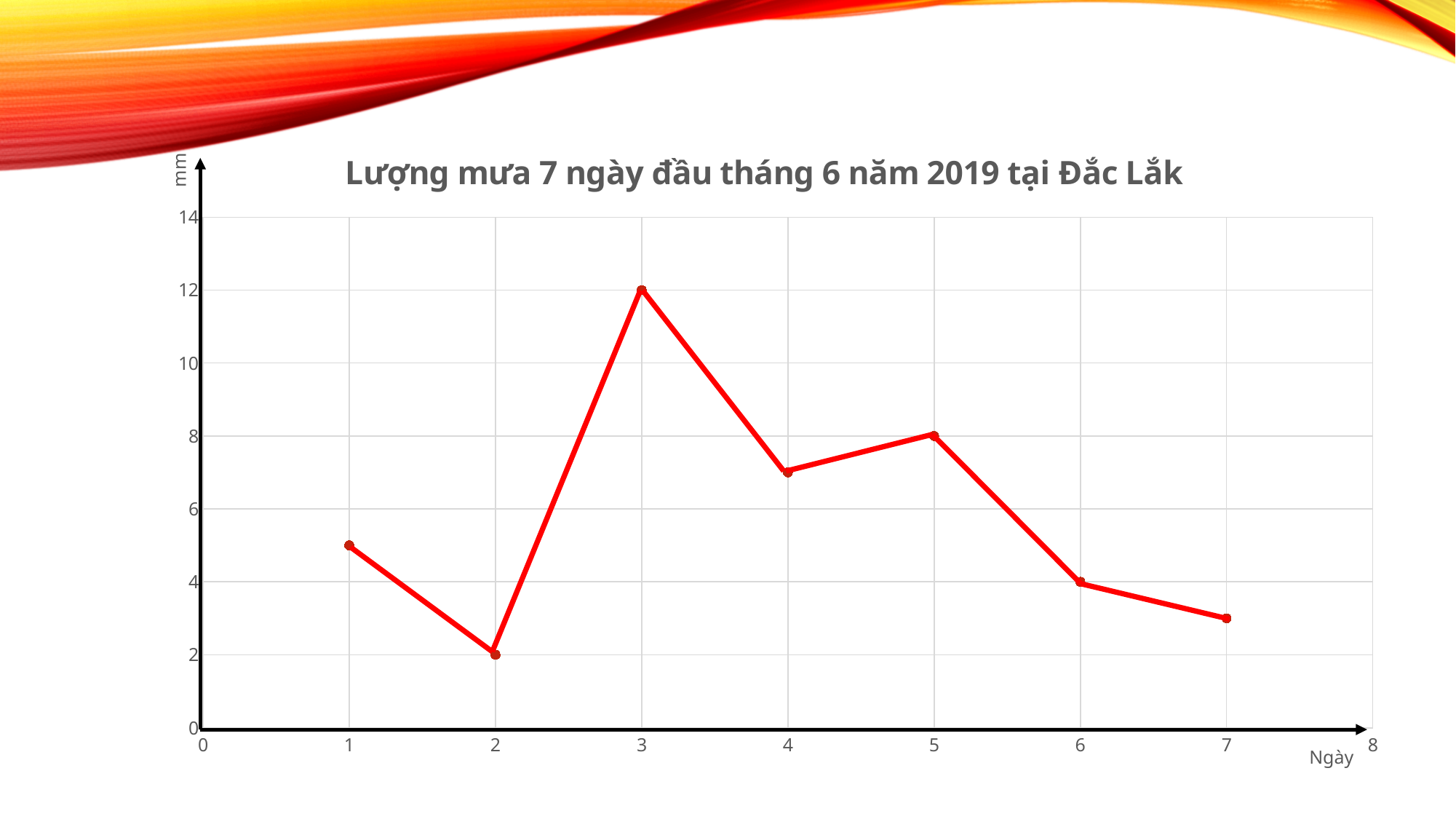
What is the rainfall value for day 5? 8 What is the rainfall value for day 2? 2 What is the rainfall value for day 3? 12 What is the difference between the rainfall on day 3 and day 2? 10 What is the title of the chart? Lượng mưa 7 ngày đầu tháng 6 năm 2019 tại Đắc Lắk How many data points are plotted on the chart? 7 Which day has the highest rainfall? Day 3 Which day has the lowest rainfall? Day 2 What type of chart is shown on the slide? Line chart Is the value for day 1 greater or less than 6? less Which day has more rainfall, day 5 or day 6? Day 5 What is the rainfall value for day 6? 4